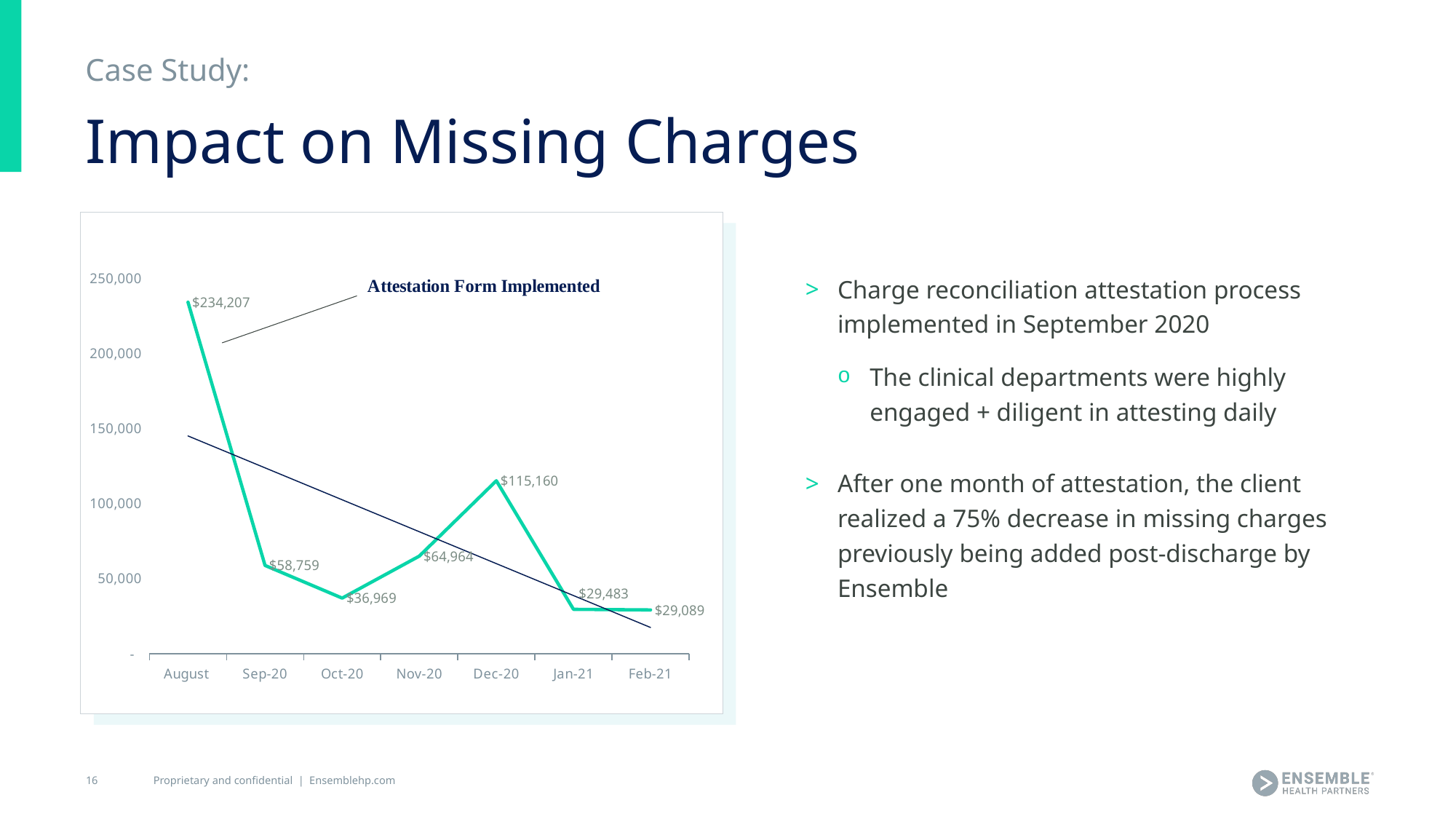
What is the value for August? $234,207 How many months are plotted on the x axis? 7 Which month has the highest value? August What is the value for Oct-20? $36,969 What is the value for Feb-21? $29,089 What is the value for Dec-20? $115,160 Which is larger, the value for Nov-20 or the value for Sep-20? Nov-20 What is the difference between the values for Dec-20 and Nov-20? $50,196 What does the annotation on the chart say? Attestation Form Implemented What kind of chart is shown? line chart What is the difference between the values for August and Sep-20? $175,448 Which month has the lowest value? Feb-21